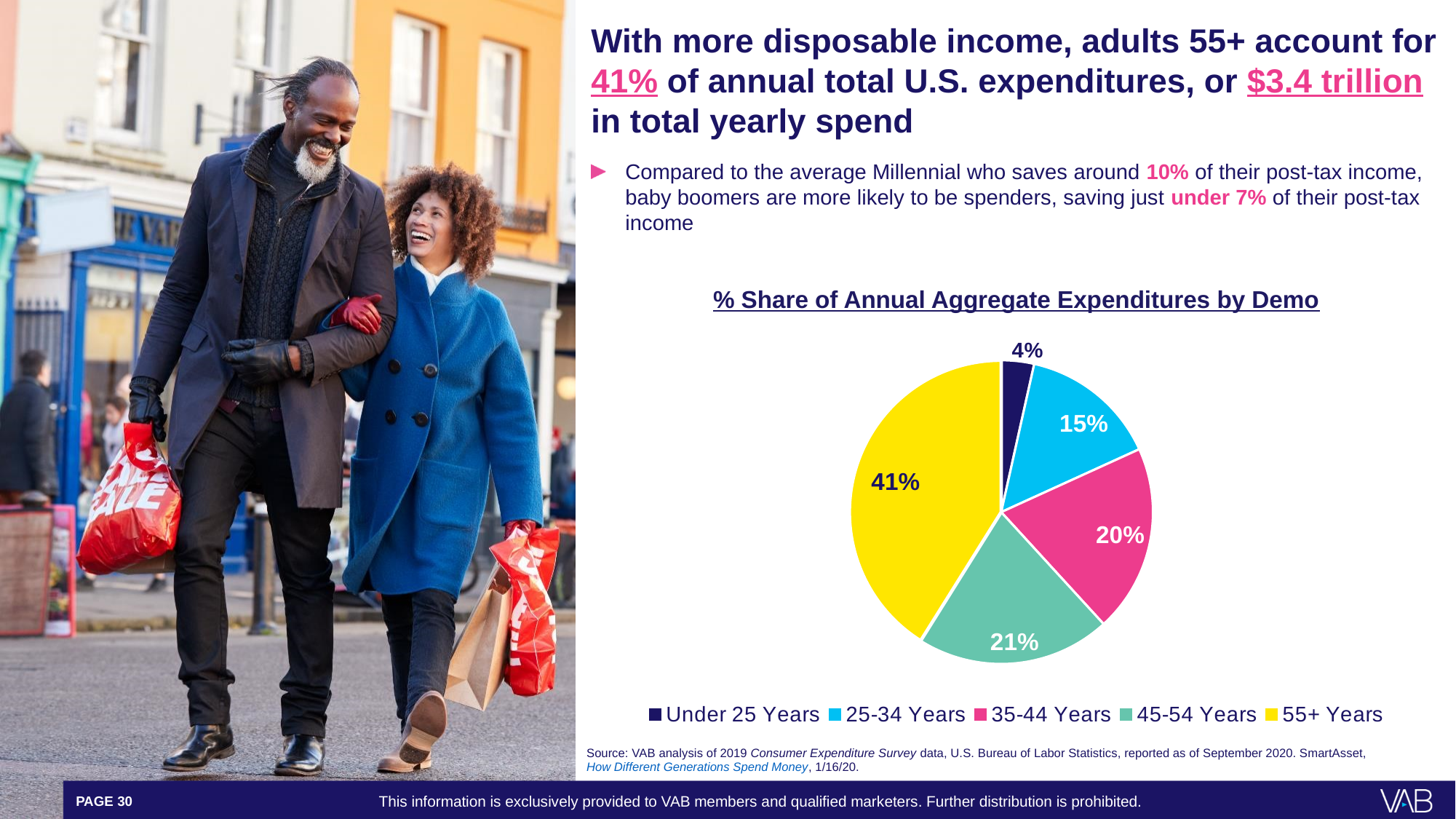
What type of chart is used to show the share of annual aggregate expenditures by demo? Pie chart What share of annual aggregate expenditures is attributed to the 35-44 Years group? 20% What share of annual aggregate expenditures is attributed to the 55+ Years group? 41% How many demographic groups are shown in the pie chart? 5 What share of annual aggregate expenditures is attributed to the Under 25 Years group? 4% What is the title of the chart? % Share of Annual Aggregate Expenditures by Demo What share of annual aggregate expenditures is attributed to the 25-34 Years group? 15% Which demographic group has the largest share of annual aggregate expenditures? 55+ Years What share of annual aggregate expenditures is attributed to the 45-54 Years group? 21% Which demographic group has the smallest share of annual aggregate expenditures? Under 25 Years What is the difference in percentage points between the 55+ Years share and the 45-54 Years share? 20 Which group has a larger share of expenditures, 25-34 Years or 35-44 Years? 35-44 Years